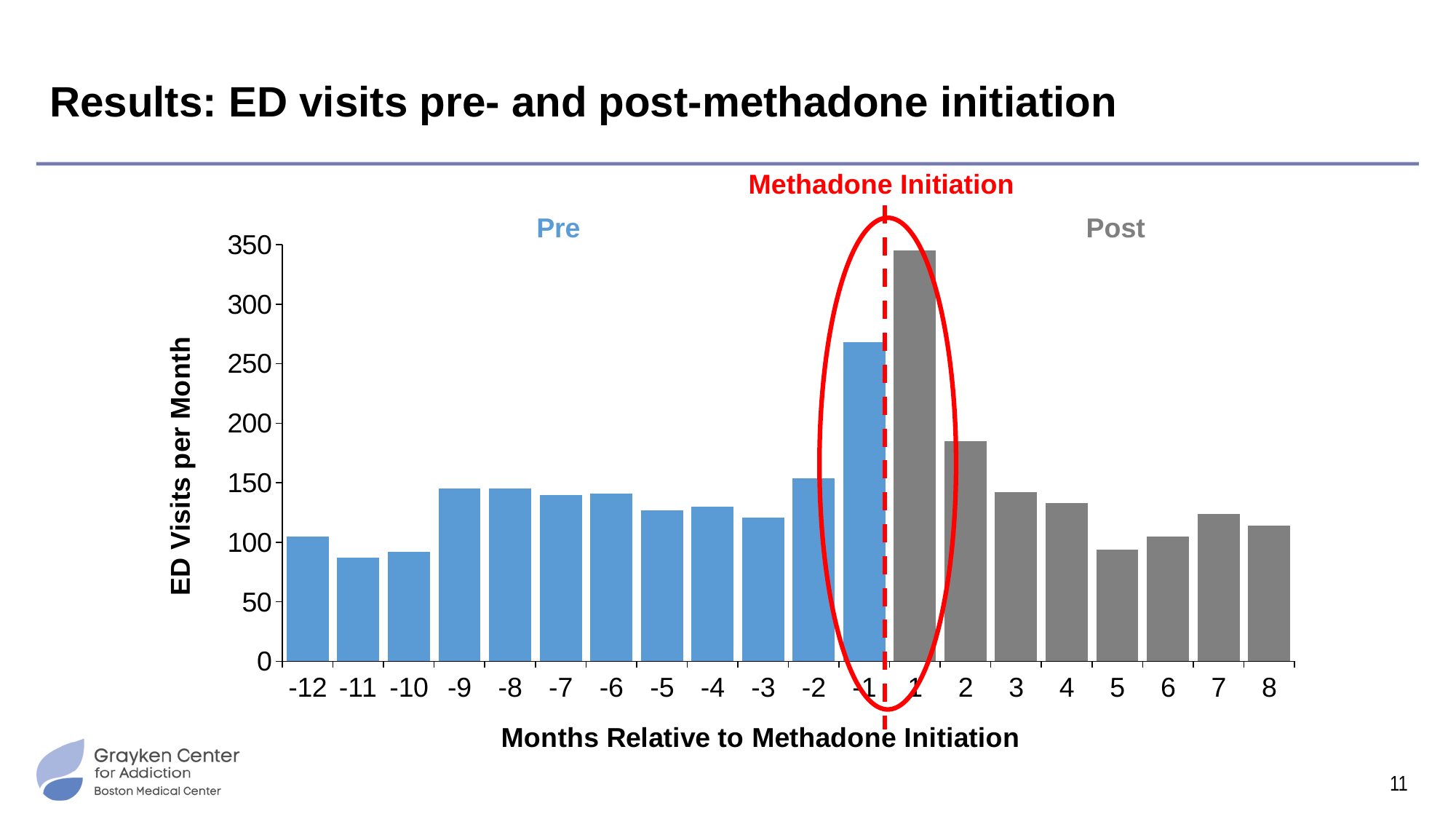
What is the title of the x axis? Months Relative to Methadone Initiation Is the value for month -3 greater or less than 150? less How many months (bars) are plotted on the chart? 20 Which month relative to methadone initiation has the highest number of ED visits per month? 1 Which has more ED visits per month: month 2 or month 3? month 2 Which has more ED visits per month: month -1 or month 1? month 1 Is the value for month 2 greater or less than 150? greater What does the red dashed vertical line on the chart mark? Methadone Initiation Is the value for month 1 greater or less than 300? greater What kind of chart is shown on the slide? bar chart